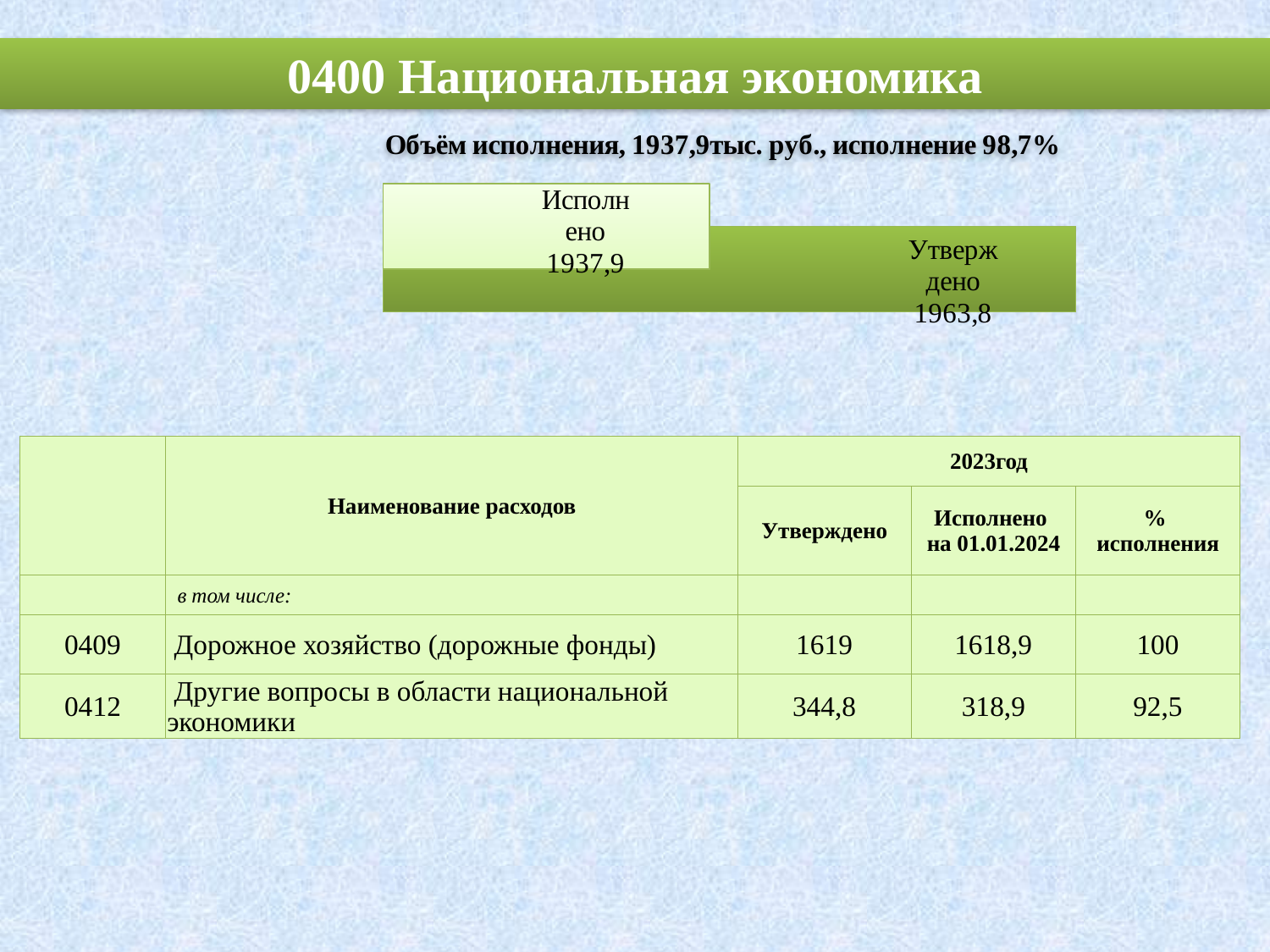
What is the difference between the Утверждено and Исполнено values in the chart? 25,9 What colour is the Утверждено bar in the chart? green How many bars are plotted in the chart? 2 Which category in the chart has the lower value? Исполнено Which bar in the chart is light green? Исполнено What is the value shown for Исполнено in the chart? 1937,9 Is the value for Исполнено larger or smaller than the value for Утверждено in the chart? smaller What is the value shown for Утверждено in the chart? 1963,8 Which category in the chart has the higher value? Утверждено What kind of chart is shown on the slide? bar chart